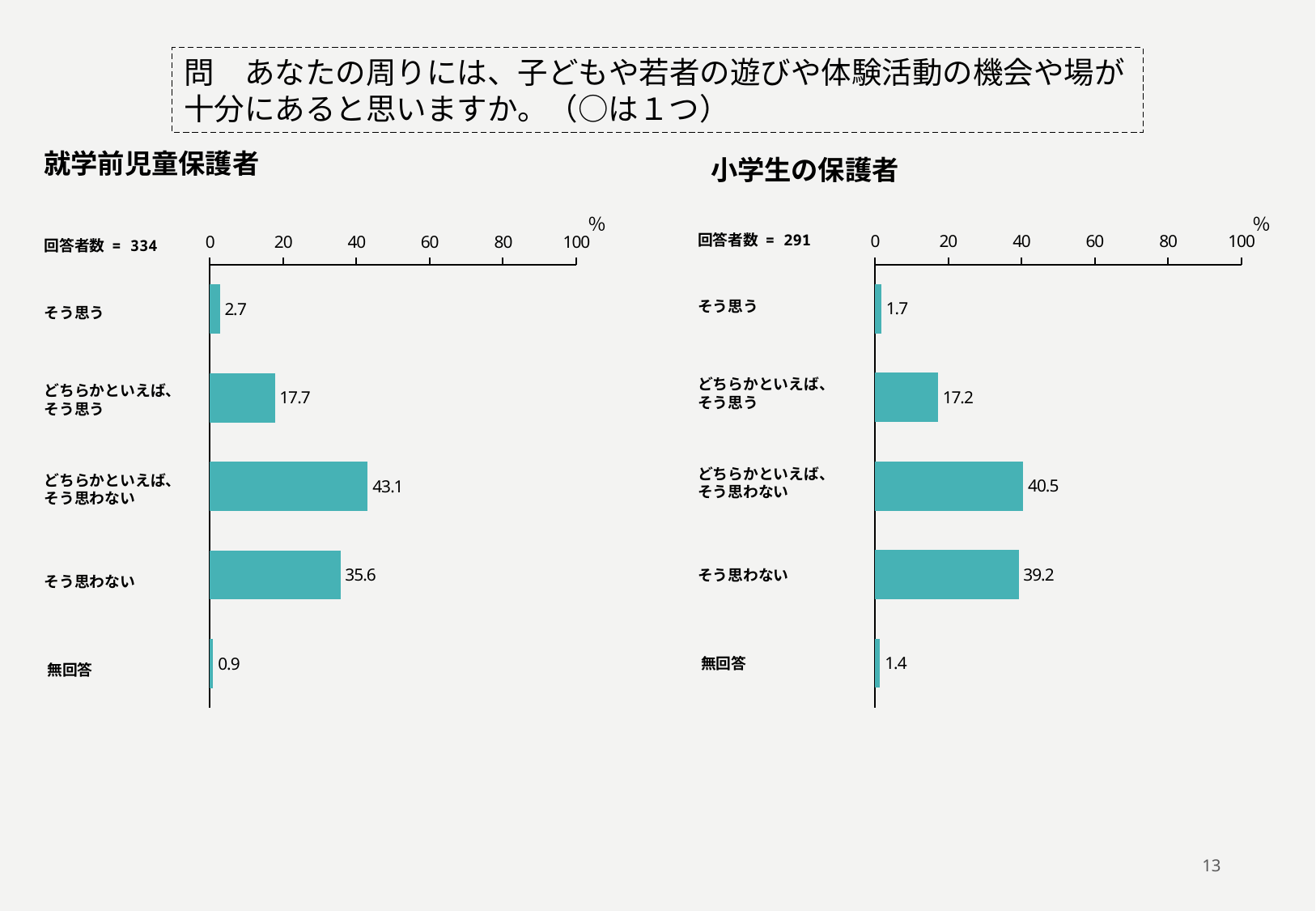
In the 小学生の保護者 chart, what is the value for どちらかといえば、そう思わない? 40.5 In the 就学前児童保護者 chart, what is the difference between どちらかといえば、そう思う and そう思う? 15.0 In the 就学前児童保護者 chart, what is the difference between どちらかといえば、そう思わない and そう思わない? 7.5 How many categories are shown in the 小学生の保護者 chart? 5 What is the number of respondents (回答者数) shown for the 就学前児童保護者 chart? 334 In the 就学前児童保護者 chart, what is the value for そう思う? 2.7 What kind of chart is the 就学前児童保護者 chart? bar chart In the 小学生の保護者 chart, which is larger: どちらかといえば、そう思う or そう思わない? そう思わない In the 就学前児童保護者 chart, which category has the highest value? どちらかといえば、そう思わない In the 就学前児童保護者 chart, is the value for そう思わない greater or less than 40? less In the 小学生の保護者 chart, what is the value for 無回答? 1.4 In the 小学生の保護者 chart, which category has the lowest value? 無回答